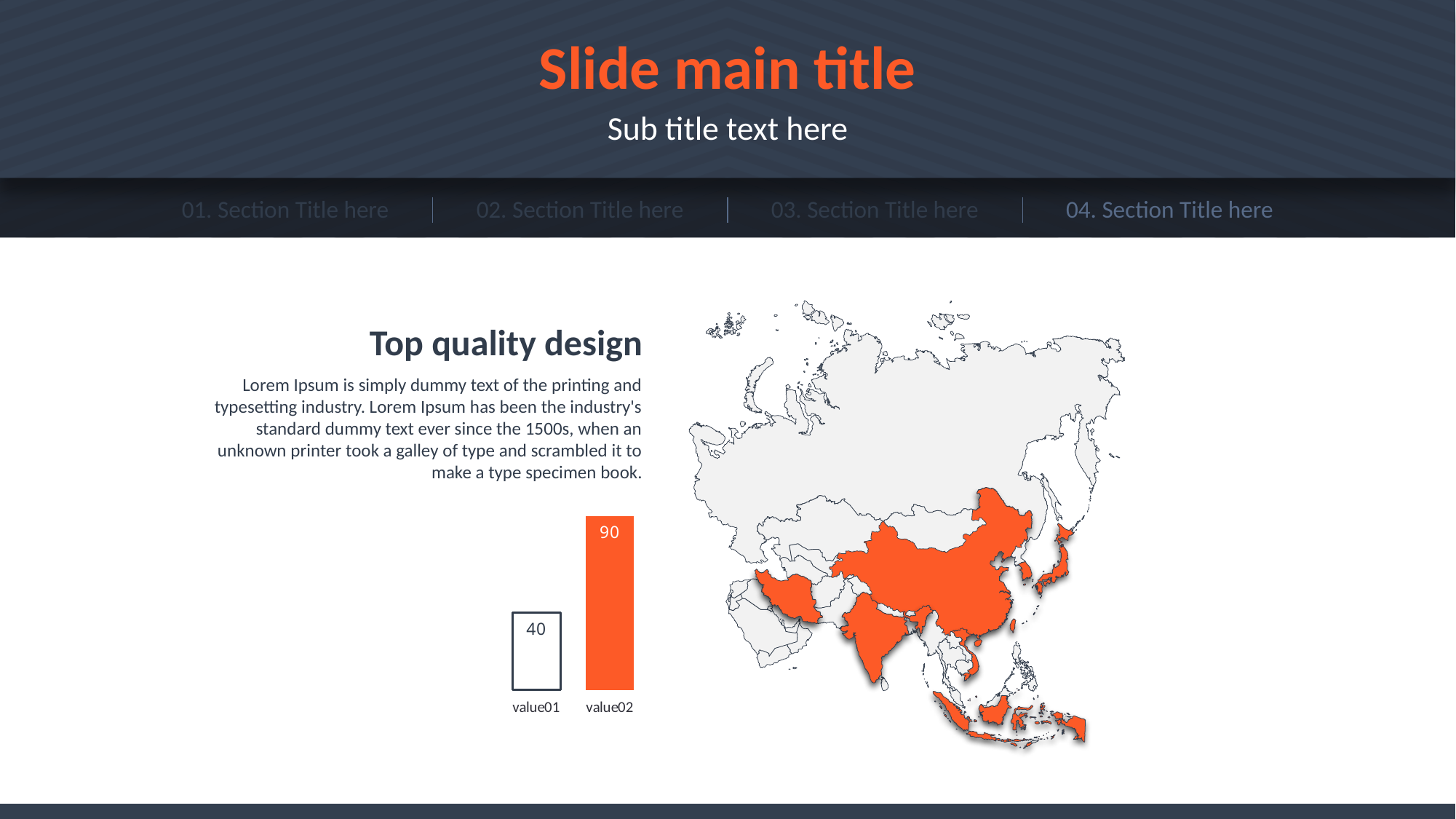
What is the value for value01 in the bar chart? 40 Which category has the lowest value in the bar chart? value01 What colour is the bar for value02 in the bar chart? orange What kind of chart is shown next to the text on the slide? bar chart Do the values rise or fall from value01 to value02 in the bar chart? rise What is the difference between the values for value02 and value01 in the bar chart? 50 Which category has the highest value in the bar chart? value02 Which bar in the bar chart is drawn as an outline with a white fill? value01 What is the total of the two values in the bar chart? 130 How many categories are shown in the bar chart? 2 Which is larger in the bar chart, value01 or value02? value02 What is the value for value02 in the bar chart? 90